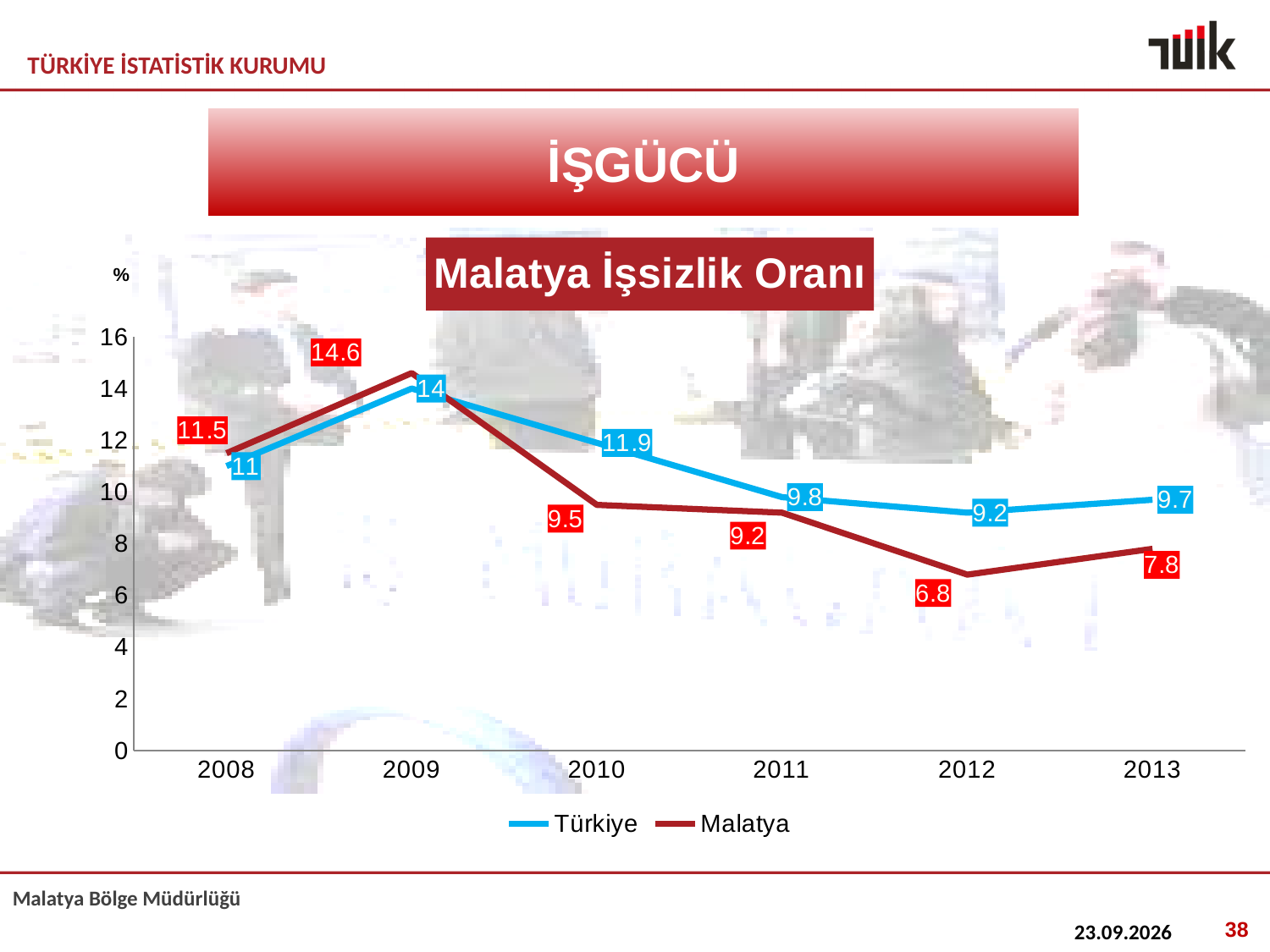
What is the title of the chart? Malatya İşsizlik Oranı How many series does the legend list? 2 Which series has the higher value in 2010, Türkiye or Malatya? Türkiye What is the Malatya unemployment rate in 2009? 14.6 What is the Malatya value for 2013? 7.8 What is the difference between the Türkiye and Malatya values in 2012? 2.4 Does the Malatya line rise or fall from 2010 to 2012? fall What type of chart is shown on the slide? line chart What is the Türkiye unemployment rate in 2012? 9.2 In which year is the Malatya unemployment rate lowest? 2012 How many years are shown on the x axis? 6 In which year is the Türkiye unemployment rate highest? 2009